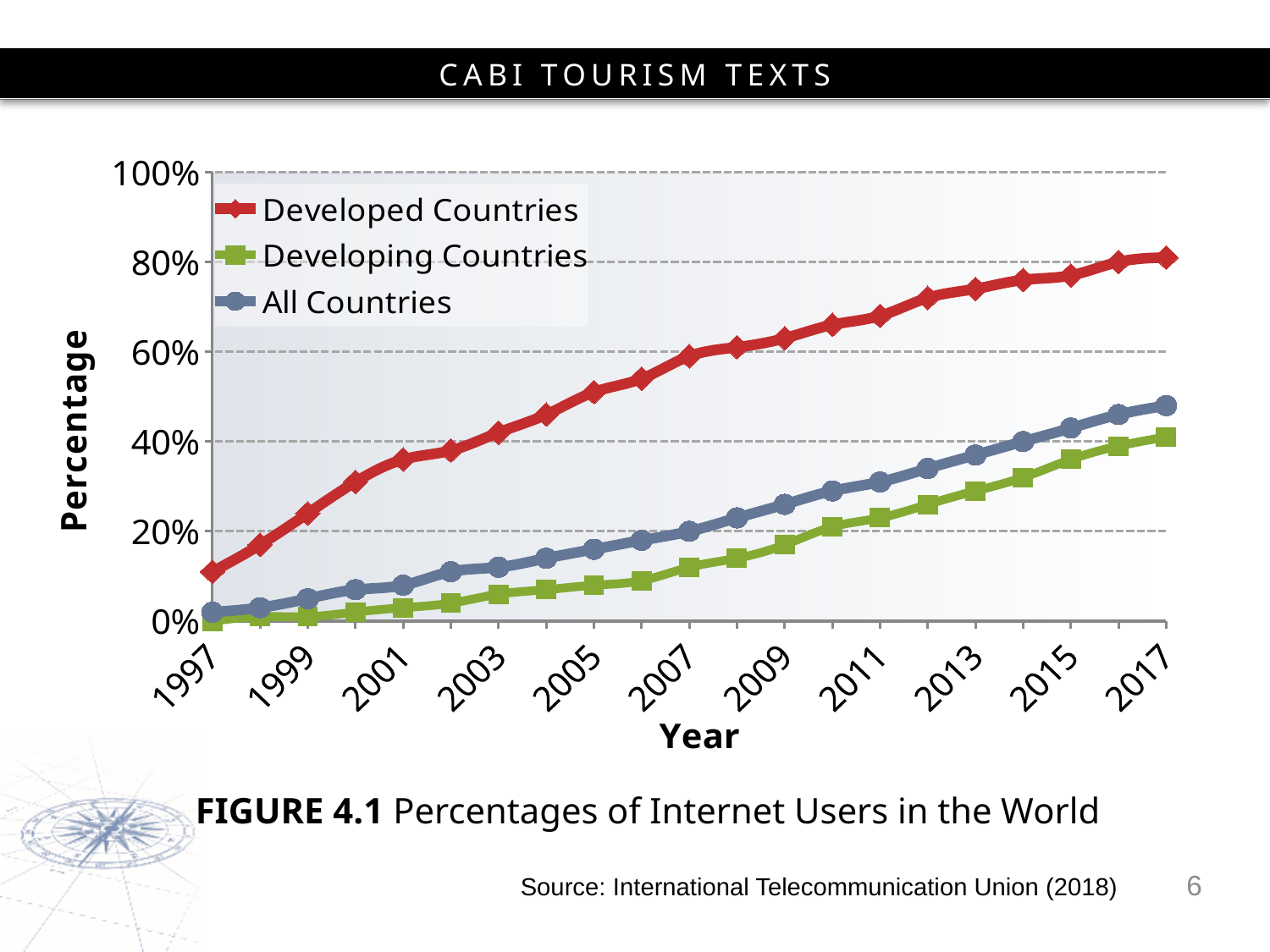
Is the value for Developed Countries in 1997 greater or less than 20%? less In 2011, which is larger: the value for All Countries or the value for Developing Countries? All Countries What is the label on the vertical axis? Percentage Which series has the lowest value in 2017? Developing Countries How many years are plotted for each series, from 1997 to 2017? 21 Is the value for Developing Countries in 2009 greater or less than 20%? less Do the values for Developing Countries rise or fall from 1997 to 2017? Rise Is the value for Developed Countries in 2013 greater or less than 60%? greater Which series has the highest value in 2017? Developed Countries What kind of chart is shown on the slide? Line chart How many series does the legend list? 3